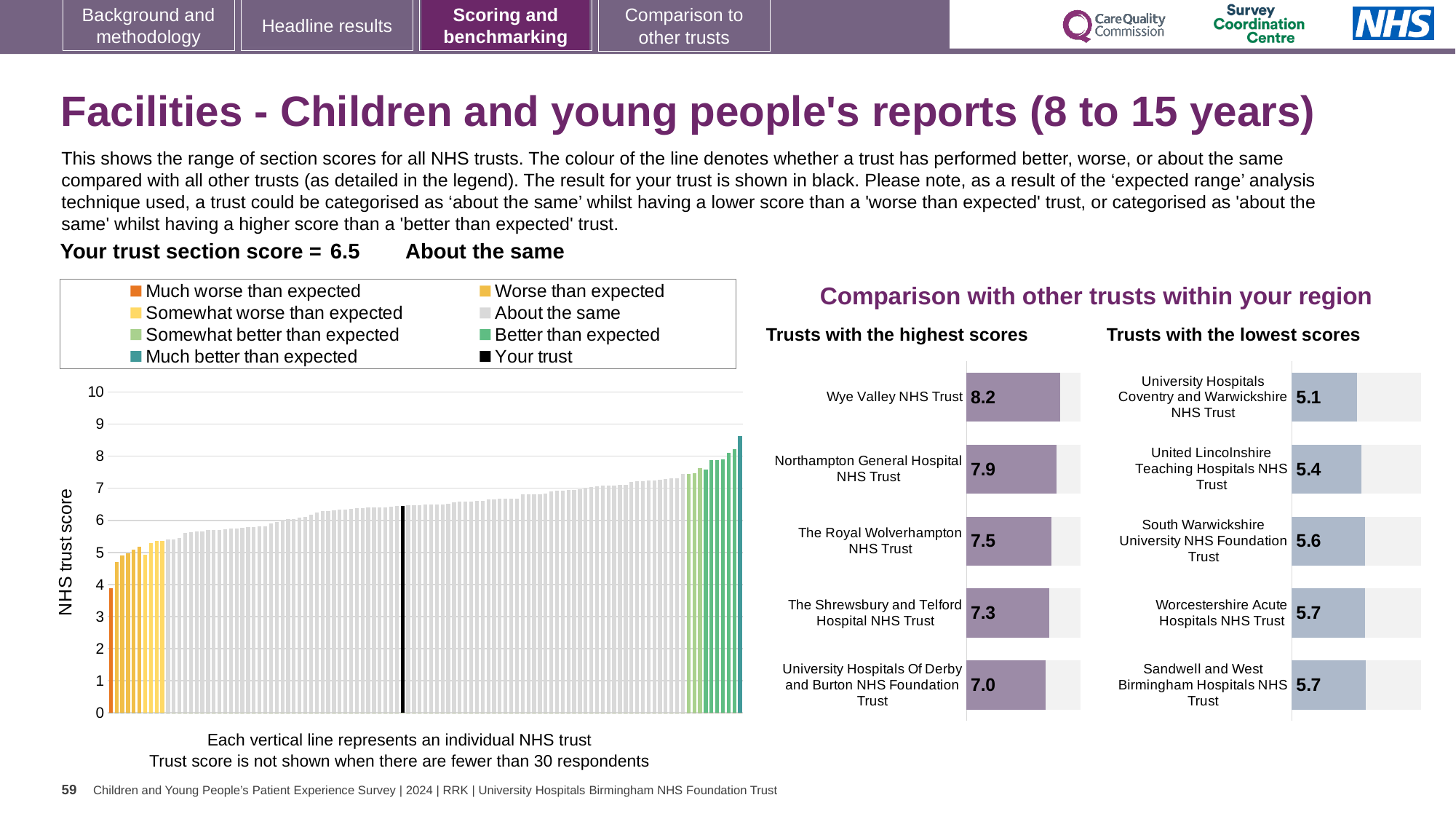
How many trusts are shown in the 'Trusts with the highest scores' chart? 5 In the 'Trusts with the highest scores' chart, which trust has the highest score? Wye Valley NHS Trust In the 'Trusts with the highest scores' chart, what is the score for Wye Valley NHS Trust? 8.2 In the main 'NHS trust score' chart, what is the section score for your trust (the black bar)? 6.5 In the 'Trusts with the lowest scores' chart, what is the score for Sandwell and West Birmingham Hospitals NHS Trust? 5.7 In the 'Trusts with the highest scores' chart, what is the difference between the scores of Wye Valley NHS Trust and University Hospitals Of Derby and Burton NHS Foundation Trust? 1.2 In the 'Trusts with the lowest scores' chart, which trust has the lowest score? University Hospitals Coventry and Warwickshire NHS Trust In the 'Trusts with the lowest scores' chart, how much higher is Worcestershire Acute Hospitals NHS Trust's score than University Hospitals Coventry and Warwickshire NHS Trust's score? 0.6 In the 'Trusts with the highest scores' chart, which has the larger score: Northampton General Hospital NHS Trust or The Royal Wolverhampton NHS Trust? Northampton General Hospital NHS Trust In the main 'NHS trust score' chart, do the values rise or fall from left to right? Rise How many entries does the legend of the main 'NHS trust score' chart list? 8 What kind of chart is the main chart on the left showing NHS trust scores? Bar chart